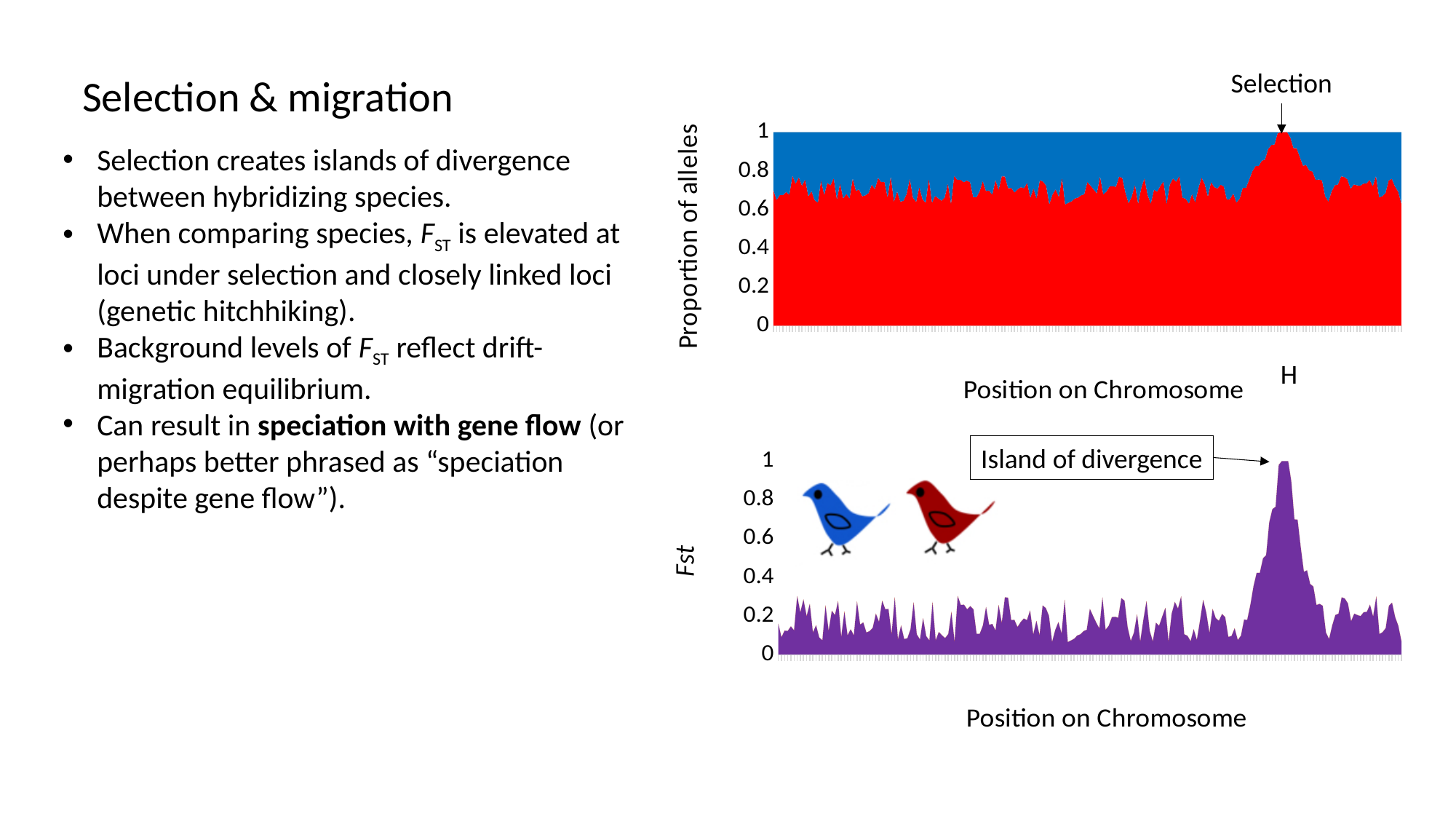
In the bottom chart (Fst), is the Fst value at the far left of the chromosome greater or less than 0.4? less What kind of chart is the top chart on the slide, labelled 'Proportion of alleles'? area chart In the top chart (Proportion of alleles), is the red proportion at the position marked 'Selection' greater or less than 0.8? greater In the bottom chart (Fst), what label does the arrow pointing to the tall peak carry? Island of divergence What is the y-axis label of the top chart on the slide? Proportion of alleles What kind of chart is the bottom chart on the slide, labelled 'Fst'? area chart How many charts are shown on the slide? 2 In the bottom chart (Fst), is the peak value at the 'Island of divergence' greater or less than 0.8? greater